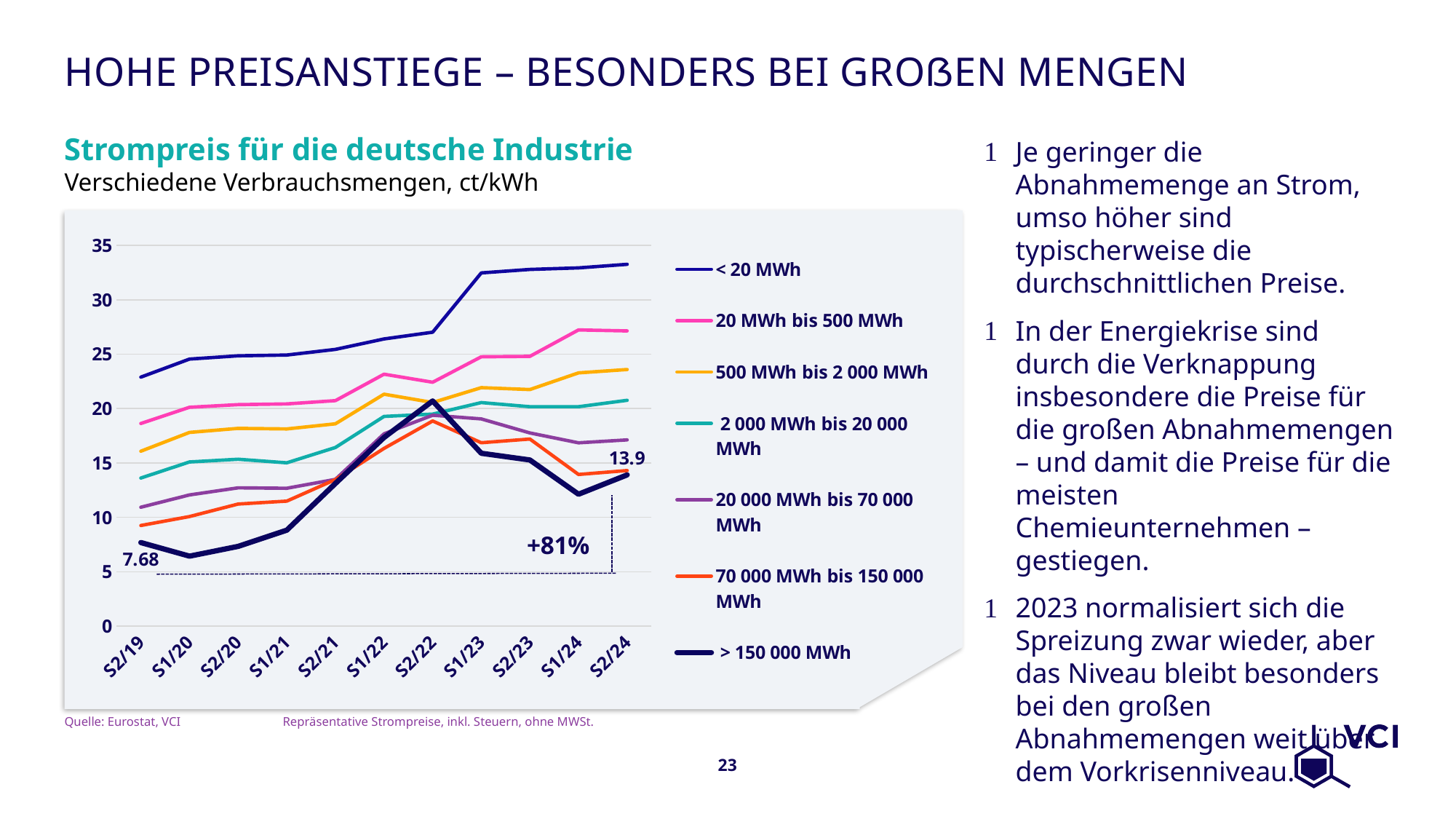
How many time periods are shown along the x axis of the chart? 11 Is the value for the < 20 MWh series at S2/24 greater or less than 30? greater Is the value for the > 150 000 MWh series at S1/20 greater or less than 10? less What is the value for the > 150 000 MWh series at S2/24? 13.9 At S1/23, which is larger: the < 20 MWh series or the 20 MWh bis 500 MWh series? < 20 MWh Which series has the lowest value at S2/19? > 150 000 MWh By how much did the > 150 000 MWh series increase from S2/19 to S2/24? 6.22 What percentage change is annotated on the chart for the > 150 000 MWh series? +81% What is the value for the > 150 000 MWh series at S2/19? 7.68 How many series does the chart's legend list? 7 Which series has the highest value at S2/24? < 20 MWh What kind of chart is shown on the slide? Line chart